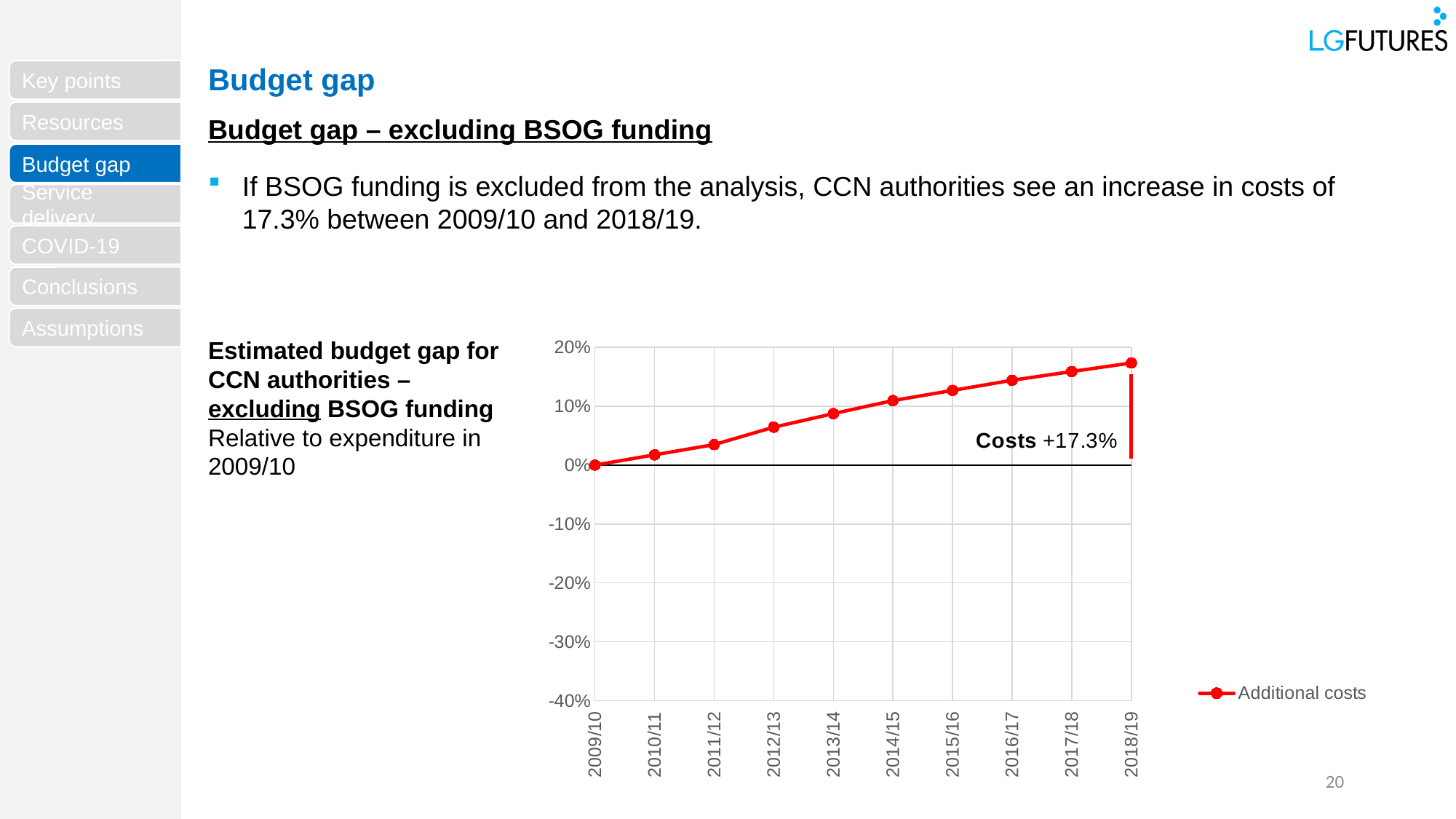
What is the increase in costs shown for 2018/19 relative to 2009/10? +17.3% Which year has the highest additional costs? 2018/19 Is the value for 2016/17 greater or less than 10%? greater How many series does the legend list? 1 How many years are plotted along the x axis? 10 What is the value for 2009/10? 0% What kind of chart is shown on the slide? Line chart Do the additional costs rise or fall from 2009/10 to 2018/19? Rise Is the value for 2013/14 greater or less than 10%? less Which year has the lowest additional costs? 2009/10 What is the name of the series shown in the legend? Additional costs Which is larger, the value for 2015/16 or the value for 2011/12? 2015/16